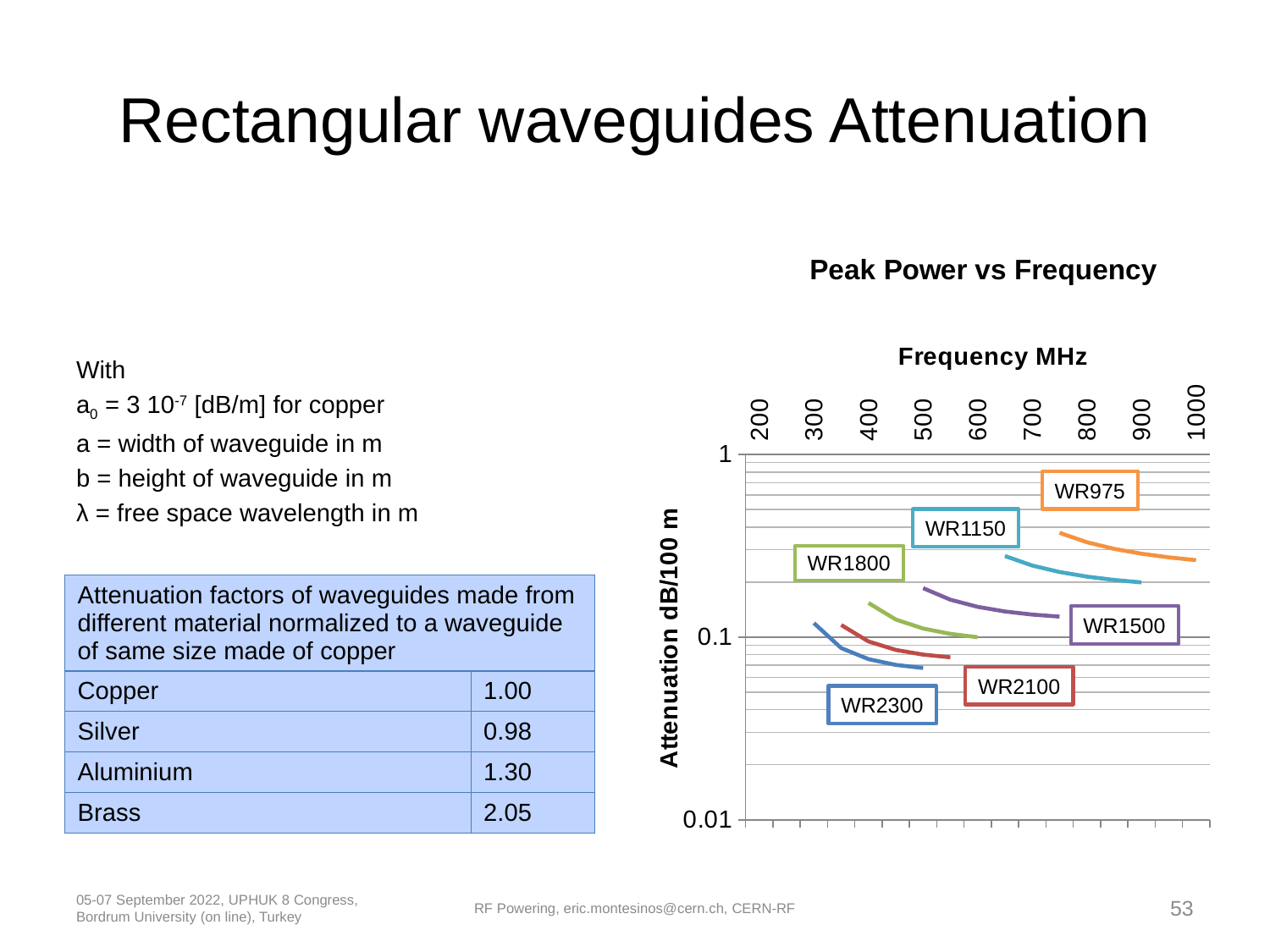
Which waveguide curve has the lowest attenuation on the chart? WR2300 Which curve shows higher attenuation, WR1500 or WR2300? WR1500 Does the attenuation of each waveguide curve rise or fall as frequency increases? fall How many waveguide curves are plotted on the chart? 6 Which curve shows higher attenuation, WR975 or WR1150? WR975 Which waveguide curve has the highest attenuation on the chart? WR975 What kind of chart is shown on the slide? line chart Is the attenuation of the WR975 curve greater or less than 0.1 dB/100 m? greater What is the title of the chart on the slide? Peak Power vs Frequency What is the label of the vertical axis of the chart? Attenuation dB/100 m